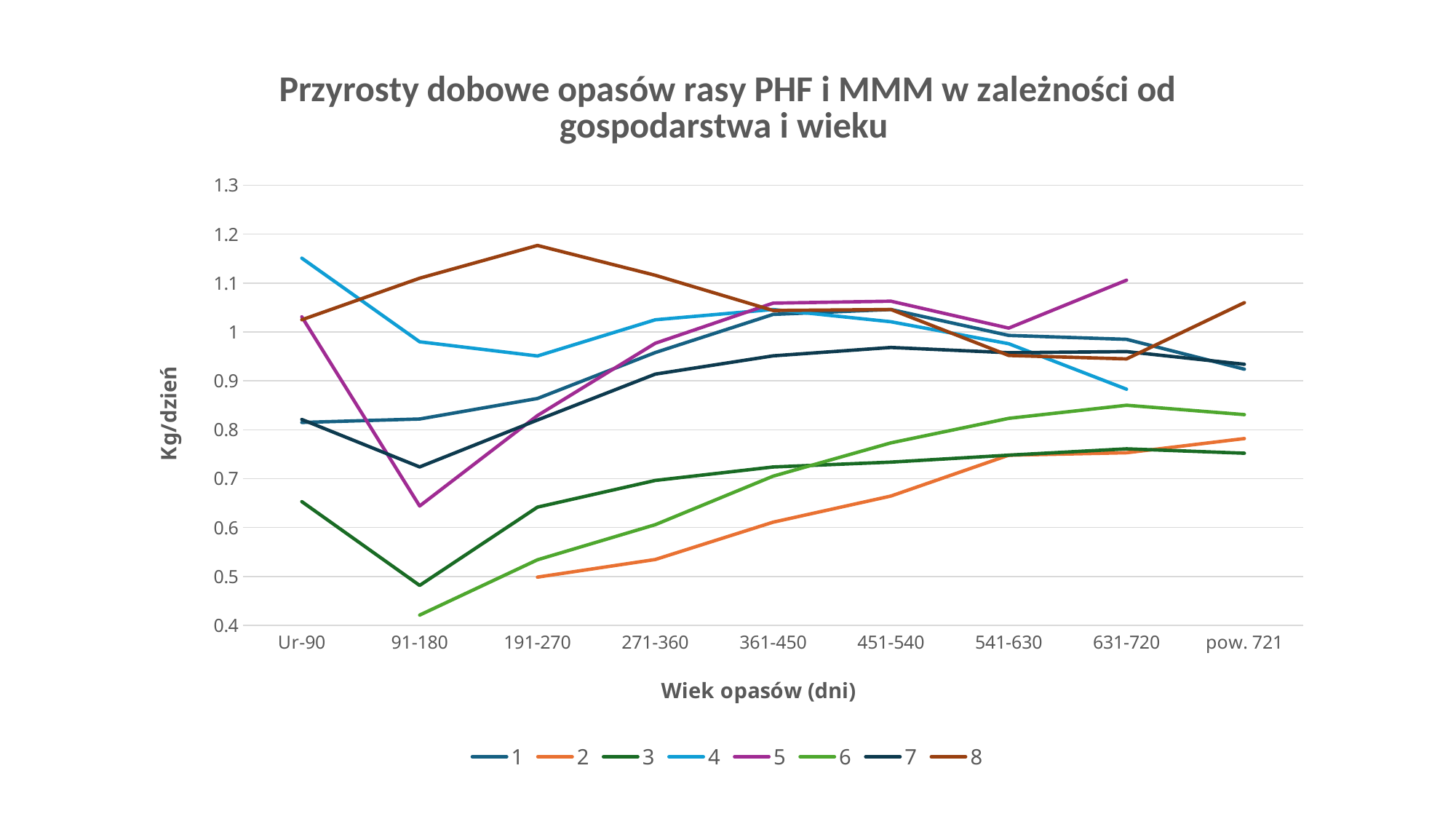
Is the value for series 4 at Ur-90 greater or less than 1.1? greater Which series has the lowest value at 91-180? 6 Is the value for series 6 at 91-180 greater or less than 0.5? less Which series has the highest value at 631-720? 5 What kind of chart is shown on the slide? line chart At 361-450, which is larger: the value for series 8 or the value for series 2? series 8 What is the label of the y axis? Kg/dzień Is the value for series 2 at 271-360 greater or less than 0.6? less How many series does the legend list? 8 Which series has the highest value at 191-270? 8 How many age categories are shown on the x axis? 9